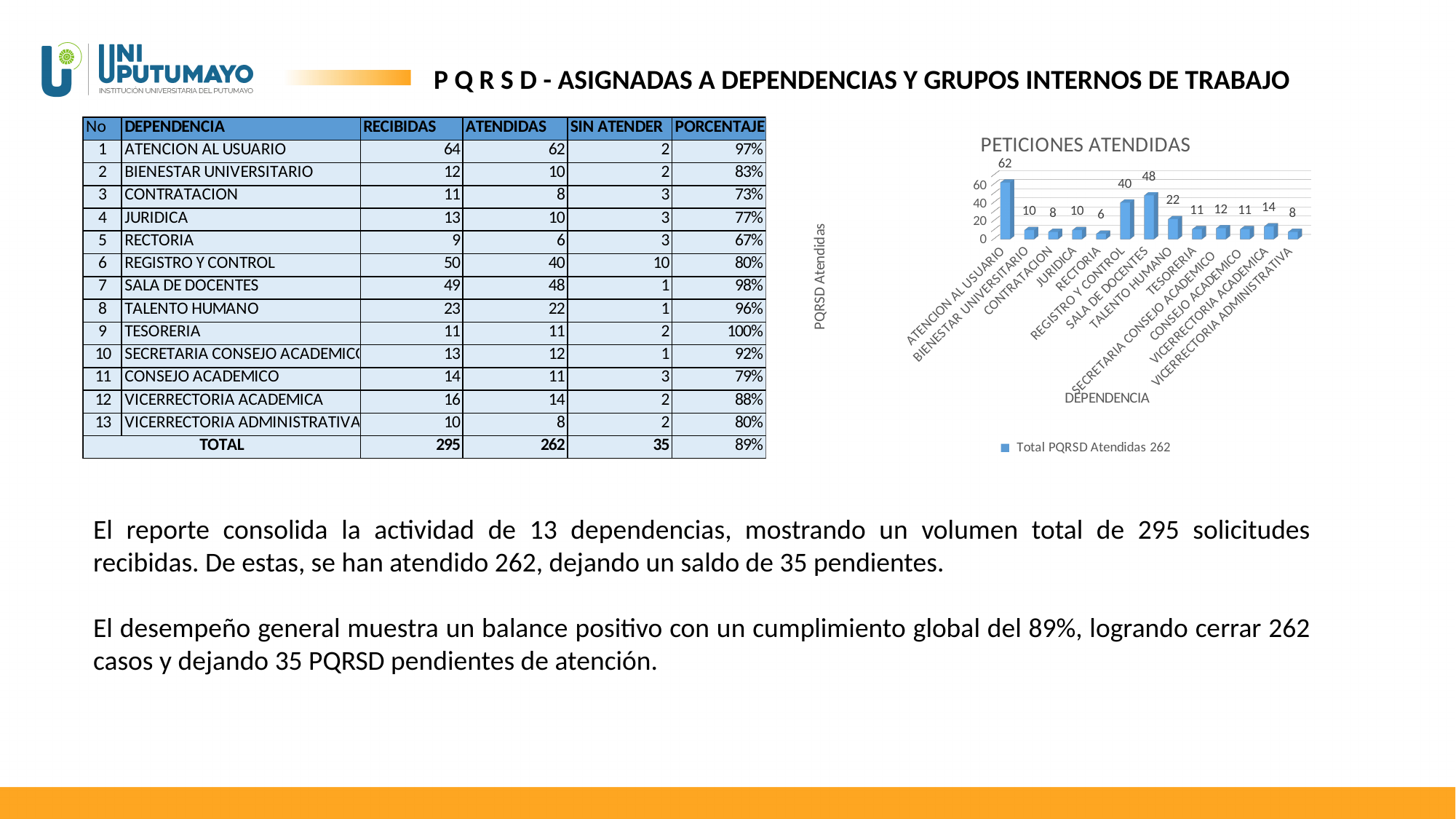
In the chart 'PETICIONES ATENDIDAS', what is the value for ATENCION AL USUARIO? 62 What is the legend entry shown in the chart 'PETICIONES ATENDIDAS'? Total PQRSD Atendidas 262 In the chart 'PETICIONES ATENDIDAS', what is the value for TALENTO HUMANO? 22 In the chart 'PETICIONES ATENDIDAS', is the value for TALENTO HUMANO greater or less than 20? greater How many dependencias (categories) are plotted in the chart 'PETICIONES ATENDIDAS'? 13 In the chart 'PETICIONES ATENDIDAS', which dependencia has the highest value? ATENCION AL USUARIO In the chart 'PETICIONES ATENDIDAS', which is larger: the value for SALA DE DOCENTES or the value for REGISTRO Y CONTROL? SALA DE DOCENTES In the chart 'PETICIONES ATENDIDAS', which dependencia has the lowest value? RECTORIA In the chart 'PETICIONES ATENDIDAS', what is the value for REGISTRO Y CONTROL? 40 What type of chart is 'PETICIONES ATENDIDAS'? Bar chart How many series does the legend of the chart 'PETICIONES ATENDIDAS' list? 1 In the chart 'PETICIONES ATENDIDAS', what is the difference between the values for ATENCION AL USUARIO and SALA DE DOCENTES? 14